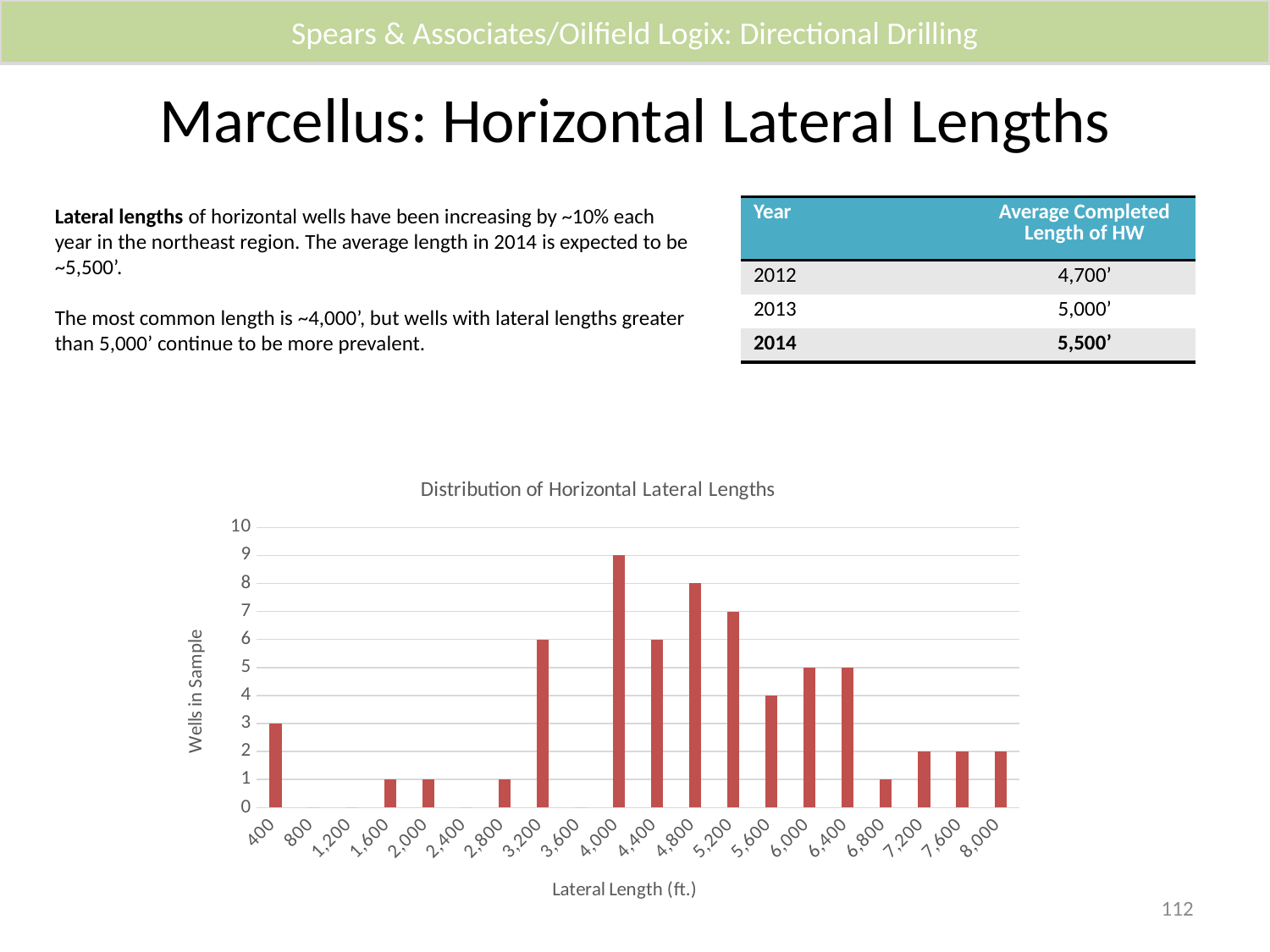
How many lateral length categories are labeled on the x axis? 20 What type of chart is shown on the slide? bar chart How many wells in the sample have a lateral length of 4,800 ft.? 8 What is the difference between the number of wells at 4,000 ft. and at 5,200 ft.? 2 How many wells in the sample have a lateral length of 400 ft.? 3 Is the number of wells at 4,800 ft. greater or less than 5? greater What is the title of the chart? Distribution of Horizontal Lateral Lengths What is the label of the y axis? Wells in Sample How many wells in the sample have a lateral length of 4,000 ft.? 9 Which has more wells in the sample: 5,600 ft. or 6,000 ft.? 6,000 How many wells in the sample have a lateral length of 3,200 ft.? 6 Which lateral length has the highest number of wells in the sample? 4,000